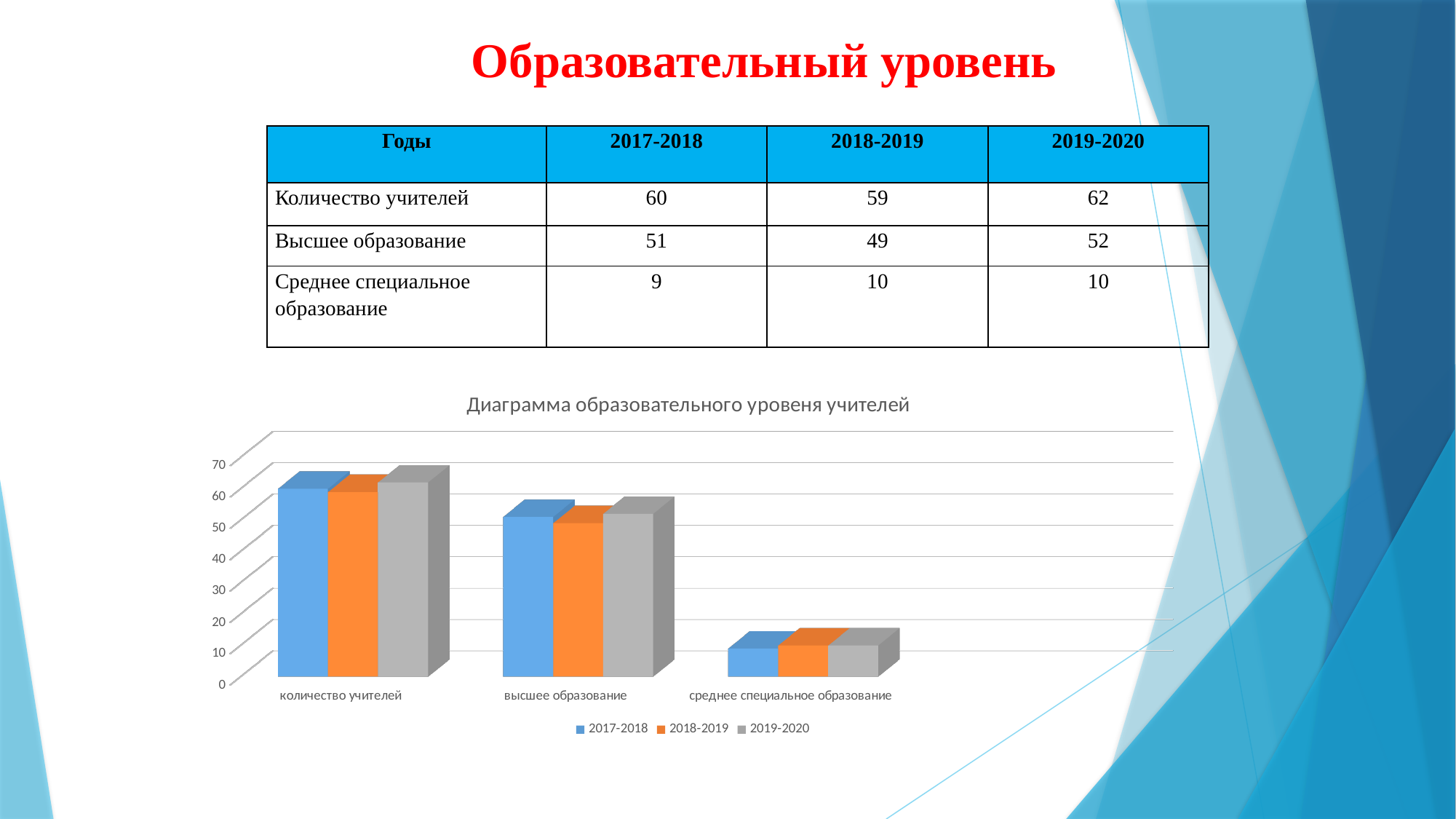
How many categories are shown along the x axis of the chart? 3 What is the value for высшее образование in 2018-2019? 49 How many series does the chart legend list? 3 What kind of chart is shown on the slide? bar chart Is the value for среднее специальное образование in 2019-2020 greater or less than 20? less Which category has the lowest values in the chart? среднее специальное образование Is the value for количество учителей in 2017-2018 greater or less than 50? greater What is the title of the chart? Диаграмма образовательного уровеня учителей What is the difference between количество учителей in 2019-2020 and in 2018-2019? 3 What is the value for среднее специальное образование in 2017-2018? 9 Which year has the larger value for высшее образование, 2017-2018 or 2018-2019? 2017-2018 What is the value for количество учителей in 2019-2020? 62